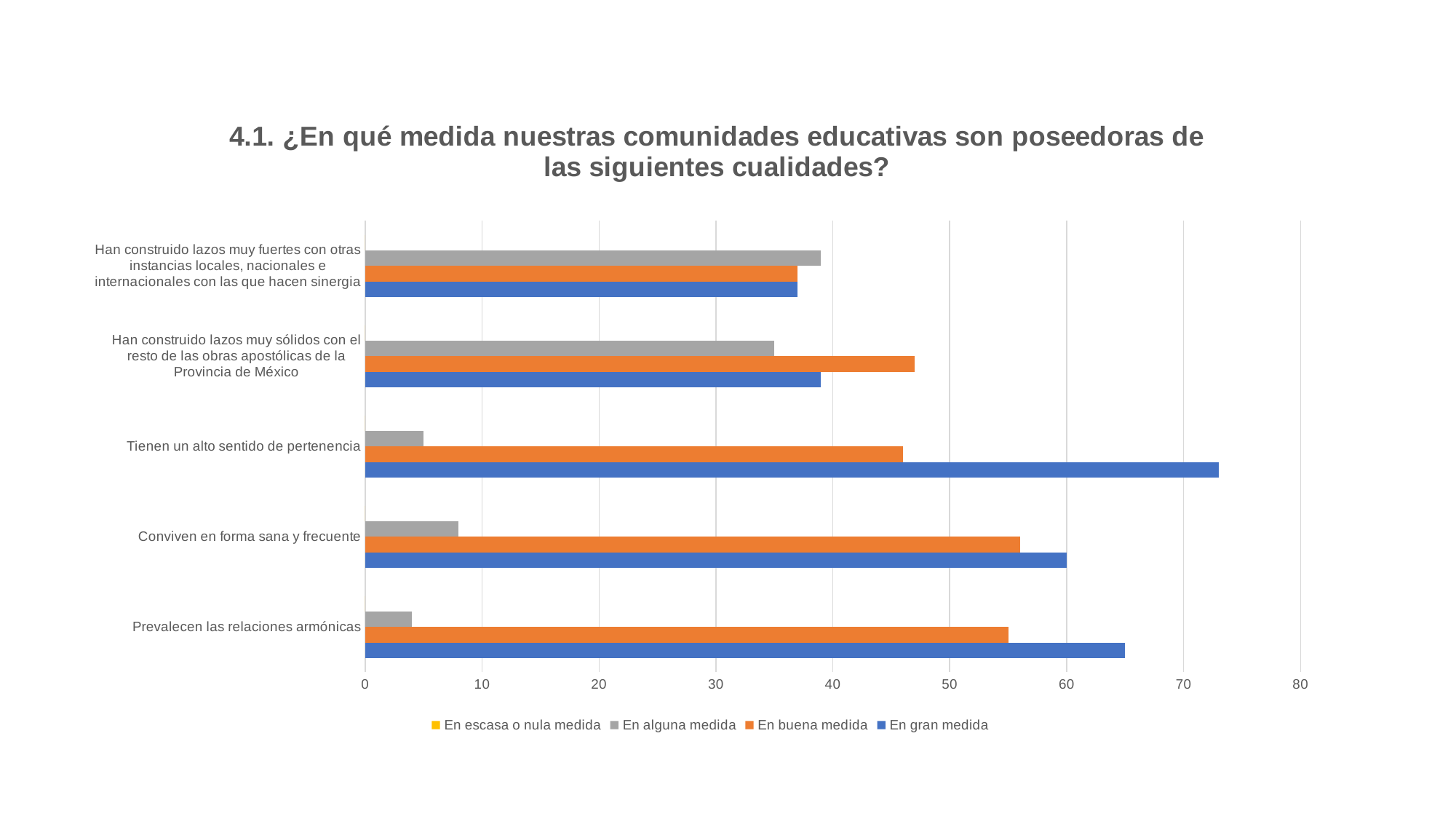
Is the 'En alguna medida' value for 'Prevalecen las relaciones armónicas' greater or less than 10? less How many series does the legend list? 4 Which category has the highest value for the series 'En gran medida'? Tienen un alto sentido de pertenencia Is the 'En gran medida' value for 'Han construido lazos muy fuertes con otras instancias locales, nacionales e internacionales con las que hacen sinergia' greater or less than 40? less For 'Prevalecen las relaciones armónicas', which series has the larger value: 'En gran medida' or 'En buena medida'? En gran medida How many categories are plotted on the vertical axis? 5 Is the 'En buena medida' value for 'Conviven en forma sana y frecuente' greater or less than 50? greater Which series is shown in blue in the legend? En gran medida What kind of chart is shown on the slide? bar chart Which category has the highest value for the series 'En alguna medida'? Han construido lazos muy fuertes con otras instancias locales, nacionales e internacionales con las que hacen sinergia For 'Han construido lazos muy sólidos con el resto de las obras apostólicas de la Provincia de México', which series has the larger value: 'En buena medida' or 'En gran medida'? En buena medida